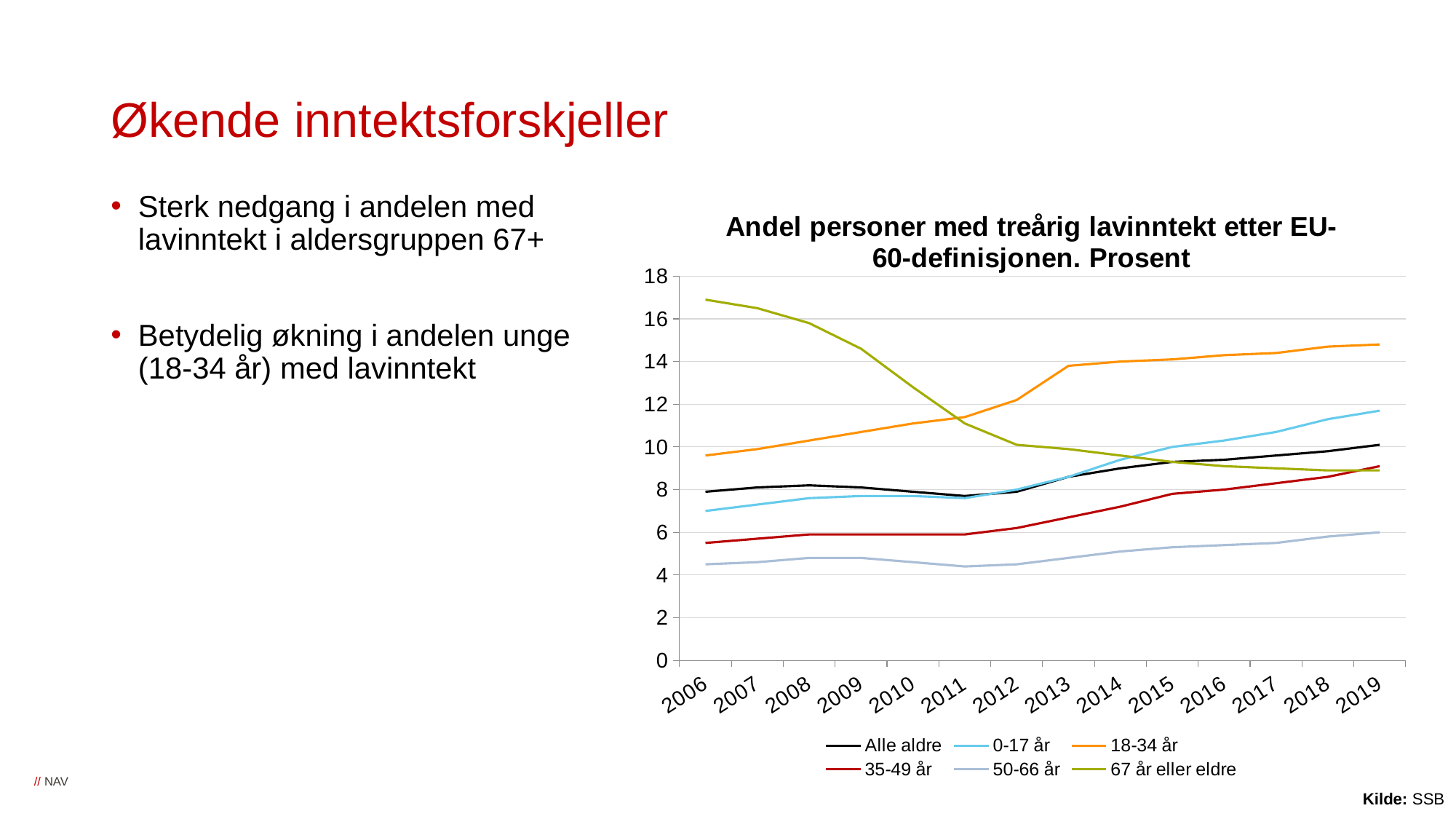
How many series does the legend of the chart list? 6 Does the line for '18-34 år' rise or fall from 2006 to 2019? Rise What is the title of the chart? Andel personer med treårig lavinntekt etter EU-60-definisjonen. Prosent What kind of chart is shown on the slide? Line chart How many years are shown on the x axis of the chart? 14 Is the value for '50-66 år' in 2011 greater or less than 6? less Which series has the highest value in 2006? 67 år eller eldre Is the value for '67 år eller eldre' in 2006 greater or less than 16? greater Which series has the lowest value in 2019? 50-66 år In 2019, which is larger: the value for '18-34 år' or for '67 år eller eldre'? 18-34 år Is the value for '18-34 år' in 2019 greater or less than 14? greater Does the line for '67 år eller eldre' rise or fall from 2006 to 2019? Fall